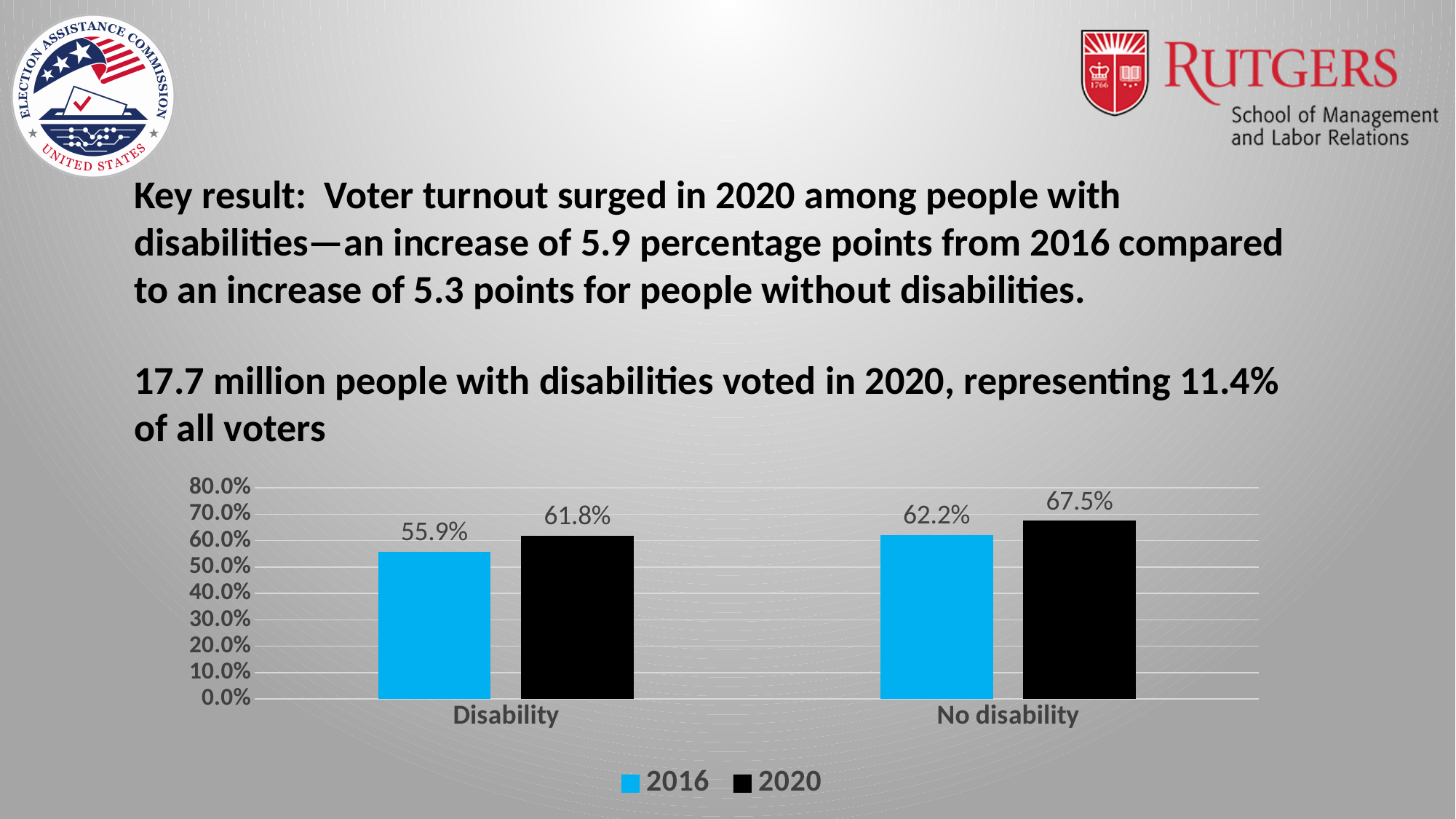
How many series does the legend list? 2 Which category has the lowest 2016 value? Disability Which category has the highest 2020 value? No disability What is the 2016 value for the No disability category? 62.2% What kind of chart is shown on the slide? Bar chart What is the difference between the 2020 and 2016 values for the Disability category? 5.9 percentage points What is the 2020 value for the No disability category? 67.5% What is the 2016 value for the Disability category? 55.9% What is the difference between the 2020 and 2016 values for the No disability category? 5.3 percentage points How many categories are shown on the x axis? 2 What is the 2020 value for the Disability category? 61.8% Which is larger: the 2020 value for Disability or the 2016 value for No disability? 2016 value for No disability